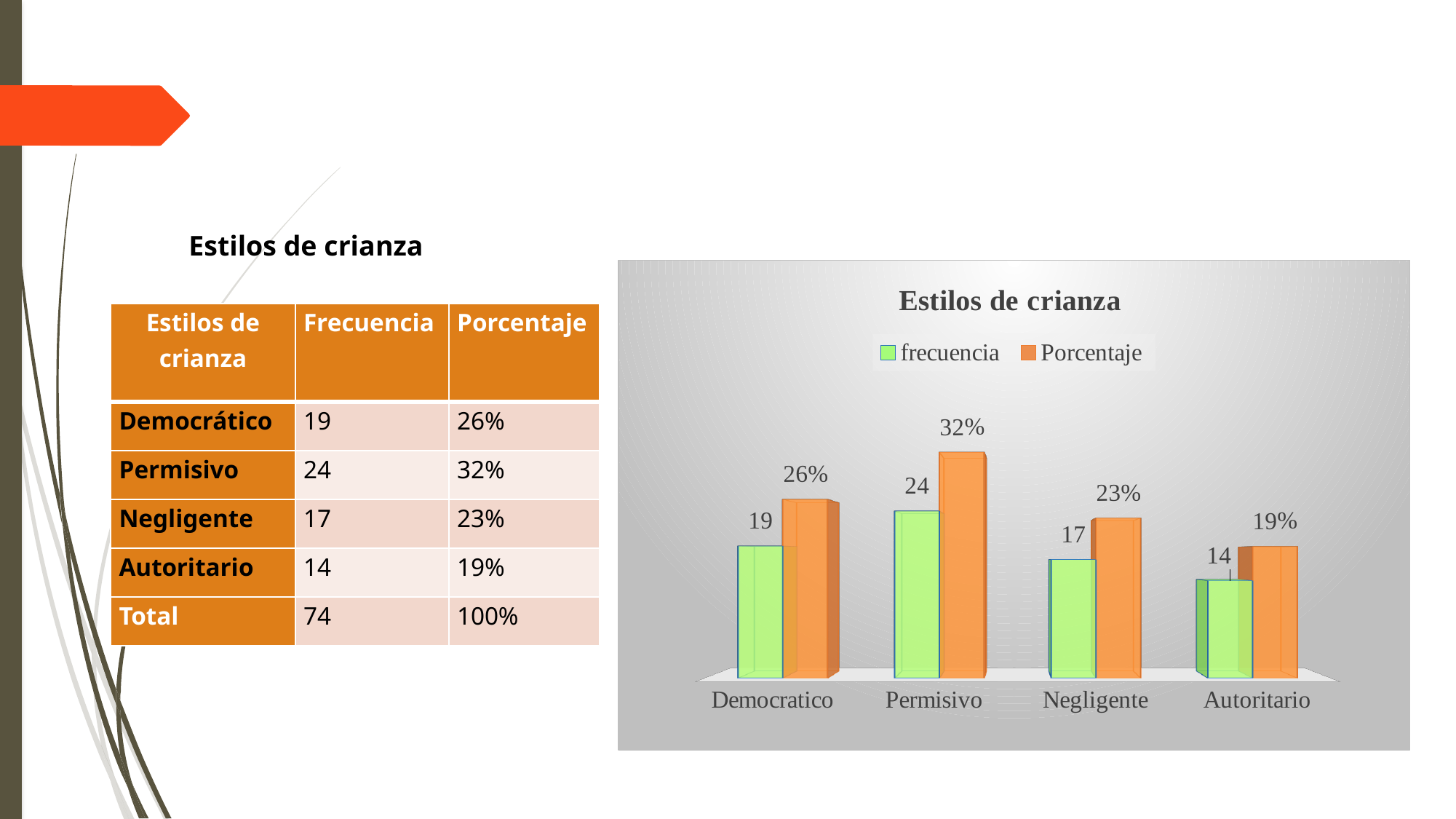
What is the Porcentaje value for Negligente in the chart? 23% Which has a higher frecuencia, Democratico or Negligente? Democratico What is the title of the chart? Estilos de crianza Which category has the highest frecuencia in the chart? Permisivo How many series does the chart legend list? 2 How many categories are shown on the x axis of the chart? 4 Which colour represents the Porcentaje series in the chart? Orange What is the difference in frecuencia between Permisivo and Democratico? 5 What kind of chart is shown on the slide? Bar chart Which category has the lowest Porcentaje in the chart? Autoritario What is the frecuencia value for Autoritario in the chart? 14 What is the frecuencia value for Permisivo in the chart? 24